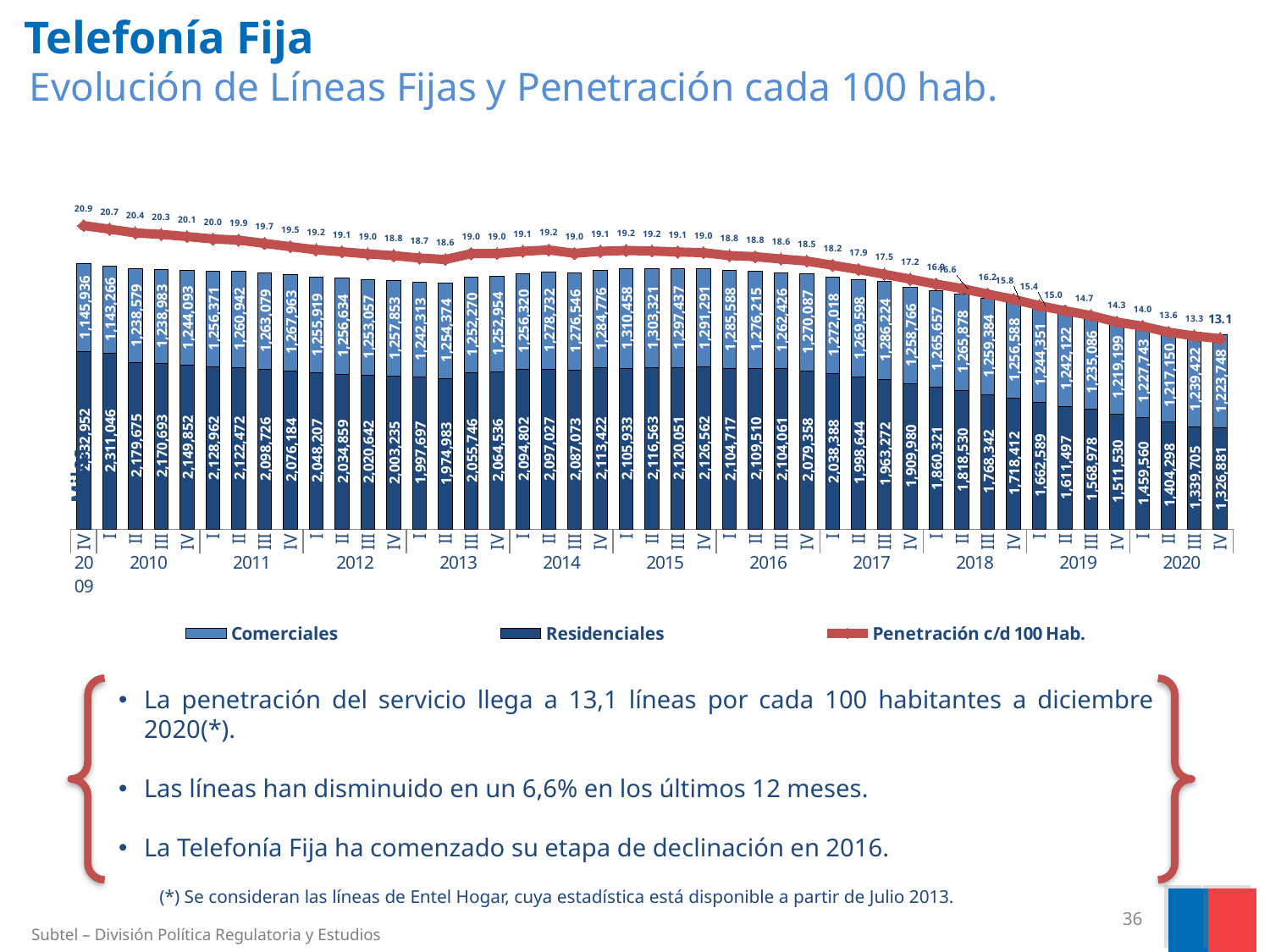
What is the Comerciales value for IV 2020? 1,223,748 What is the Penetración c/d 100 Hab. value for IV 2020? 13.1 Does the Penetración c/d 100 Hab. line rise or fall overall from IV 2009 to IV 2020? Fall How many series does the legend list? 3 What is the total of the stacked bar (Comerciales plus Residenciales) for IV 2020? 2,550,629 What kind of chart is shown on the slide? Combined stacked bar and line chart What is the difference between the Penetración c/d 100 Hab. value for IV 2009 and for IV 2020? 7.8 What is the Residenciales value for IV 2009? 2,332,952 In which quarter is the Residenciales value lowest? IV 2020 In which quarter is the Penetración c/d 100 Hab. value highest? IV 2009 What is the Residenciales value for I 2018? 1,860,321 Which is larger, the Residenciales value for IV 2015 or for IV 2019? IV 2015